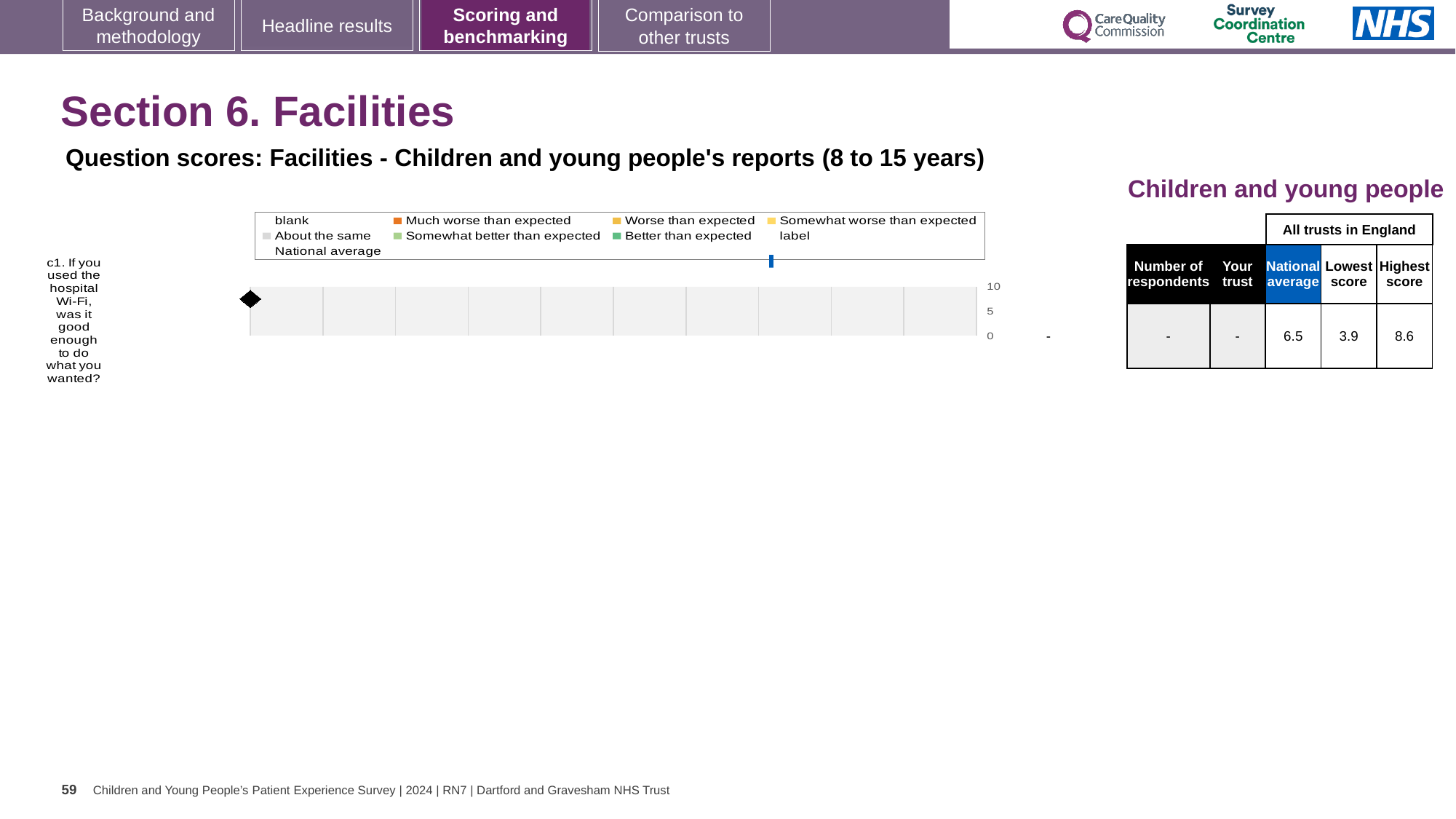
In the table next to the chart, which is larger: the National average or the Lowest score? National average In the table next to the chart, what is the National average score for question c1? 6.5 How many question categories are plotted on the chart? 1 In the table next to the chart, what is the Lowest score among all trusts in England? 3.9 What kind of chart is shown on the slide? Bar chart What is the highest tick value shown on the chart's value axis? 10 In the table next to the chart, what value is shown for Your trust? - In the table next to the chart, what is the difference between the Highest score and the Lowest score? 4.7 In the table next to the chart, what is the Highest score among all trusts in England? 8.6 How many entries does the chart legend list? 9 Which legend entry is shown with an orange marker? Much worse than expected